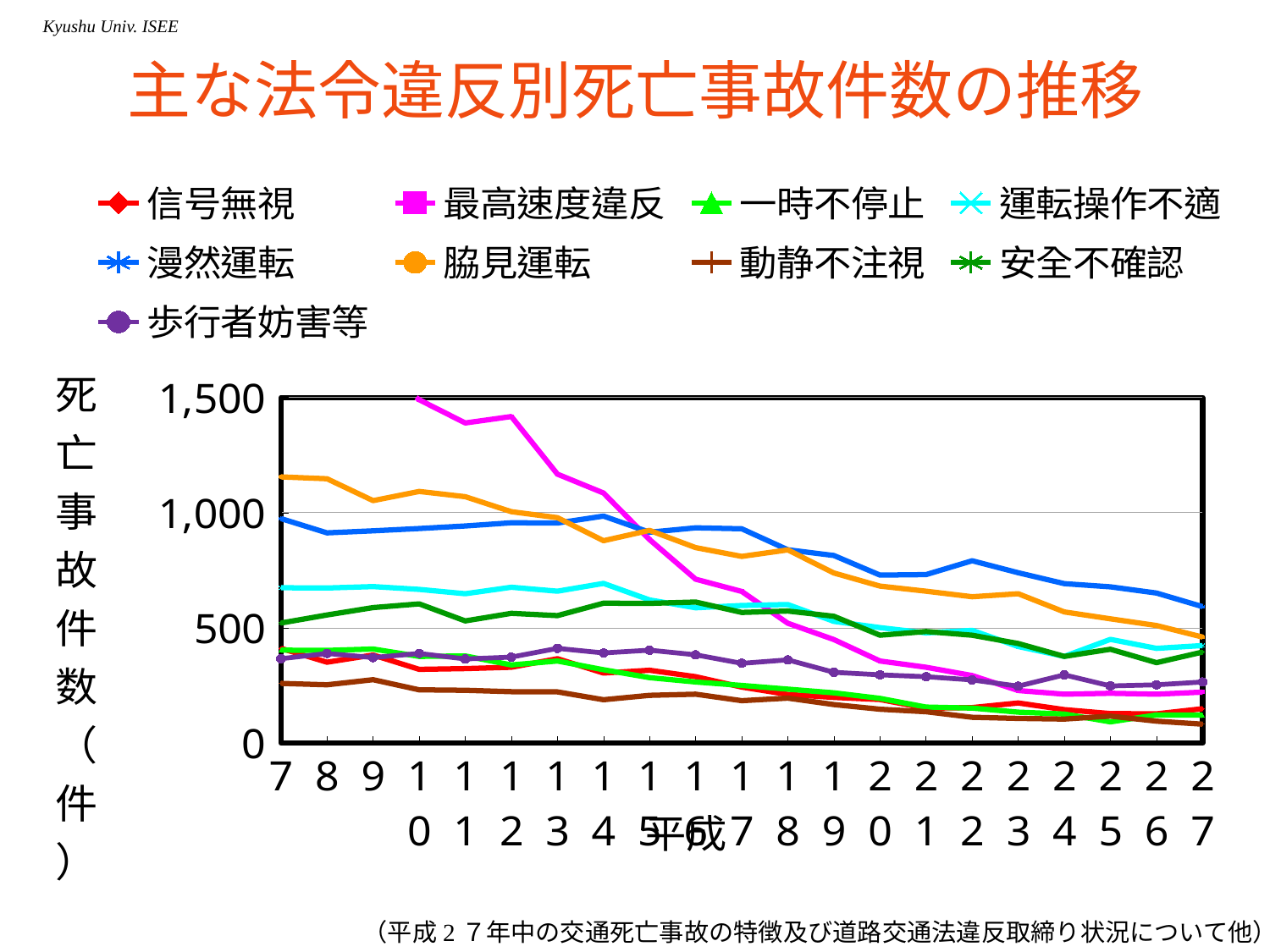
Is the value for 動静不注視 in 平成7 greater or less than 500? less How many series does the legend list? 9 Is the value for 脇見運転 in 平成27 greater or less than 500? less Which series has the highest value in 平成12? 最高速度違反 What kind of chart is shown on the slide? line chart Is the value for 漫然運転 in 平成27 greater or less than 500? greater What is the title of the chart? 主な法令違反別死亡事故件数の推移 Which series has the highest value in 平成27? 漫然運転 What is the label of the y axis? 死亡事故件数（件） Does the value for 最高速度違反 rise or fall from 平成10 to 平成27? fall How many years (points) are shown along the x axis? 21